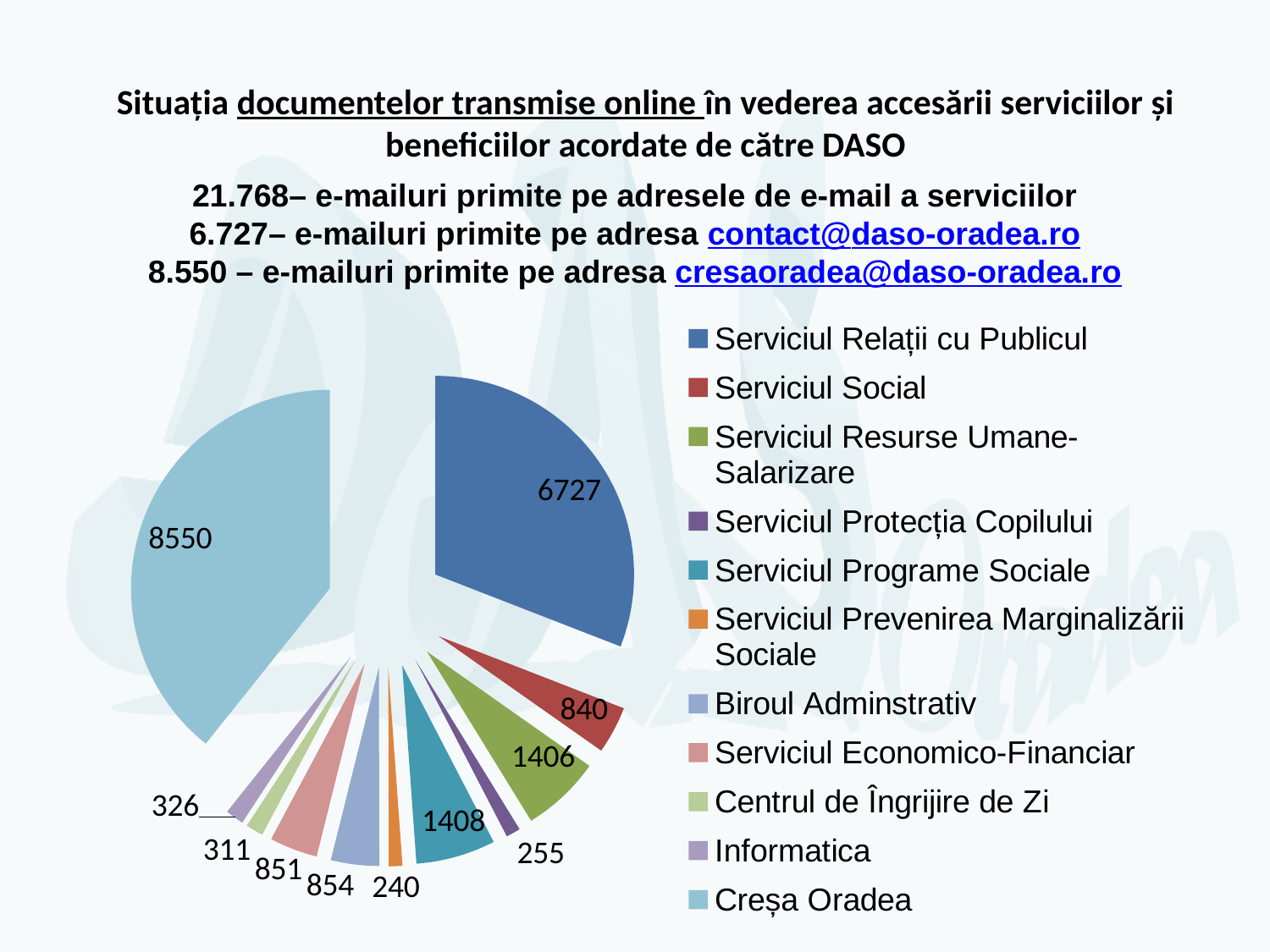
What is the value for Biroul Adminstrativ in the pie chart? 854 What is the value for Serviciul Relații cu Publicul in the pie chart? 6727 How many categories does the legend of the pie chart list? 11 What is the difference between the values for Informatica and Centrul de Îngrijire de Zi? 15 What is the value for Serviciul Protecția Copilului in the pie chart? 255 What is the value for Creșa Oradea in the pie chart? 8550 Which category has the largest slice in the pie chart? Creșa Oradea What is the difference between the values for Creșa Oradea and Serviciul Relații cu Publicul? 1823 Which is larger in the pie chart, Serviciul Resurse Umane-Salarizare or Serviciul Social? Serviciul Resurse Umane-Salarizare Which category has the smallest slice in the pie chart? Serviciul Prevenirea Marginalizării Sociale What is the value for Serviciul Social in the pie chart? 840 What type of chart is shown on the slide? pie chart